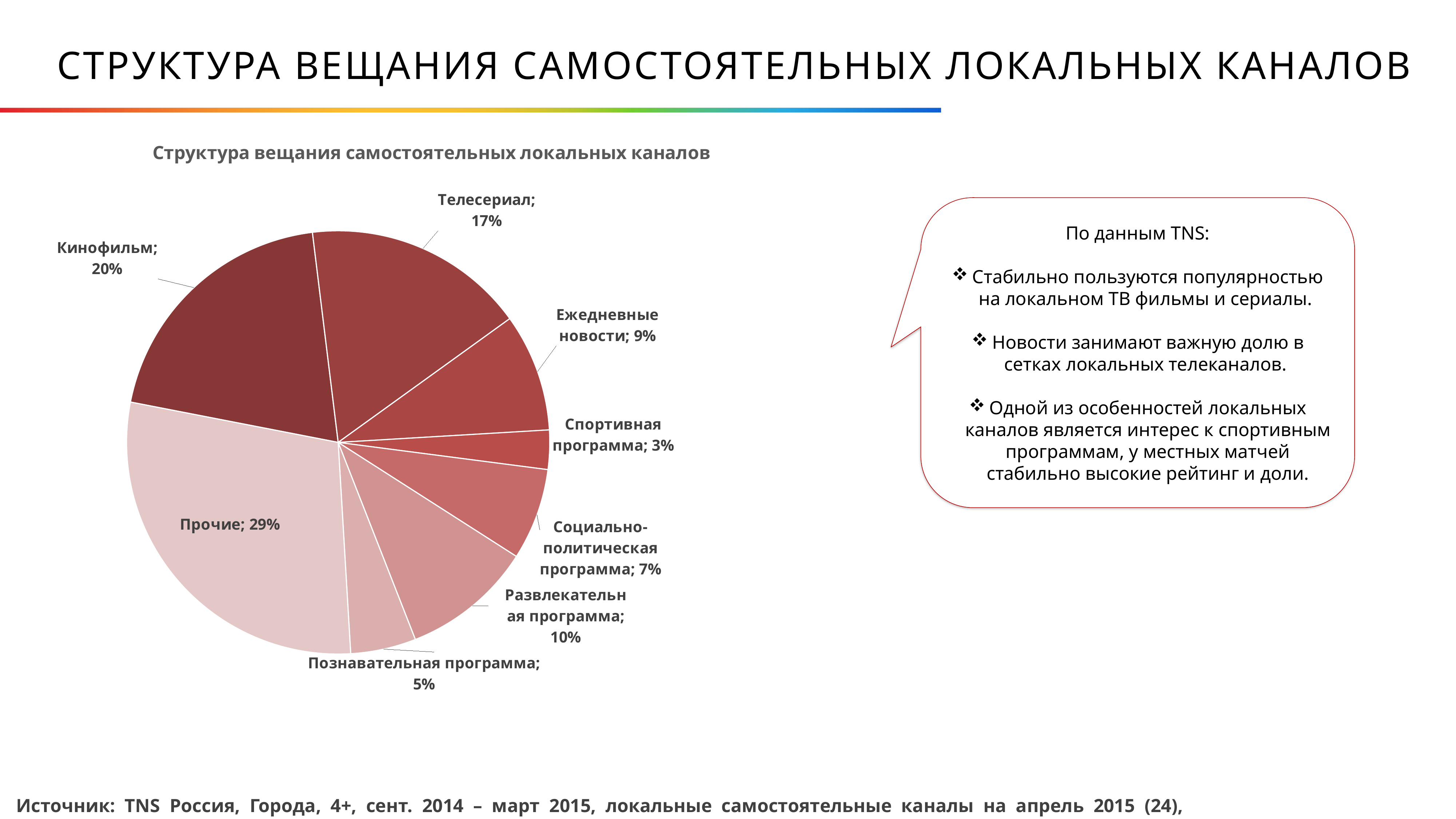
What is the combined share of Познавательная программа and Развлекательная программа? 15% Which category has the smallest share of the pie? Спортивная программа What share of broadcasting is Спортивная программа? 3% How many slices does the pie chart have? 8 What share of broadcasting is Телесериал? 17% Which has a larger share, Развлекательная программа or Социально-политическая программа? Развлекательная программа What kind of chart is shown on the slide? Pie chart Which category has the largest share of the pie? Прочие What is the difference between the shares of Кинофильм and Телесериал? 3% What share of broadcasting is Кинофильм? 20% What is the chart's title? Структура вещания самостоятельных локальных каналов What share of broadcasting is Ежедневные новости? 9%